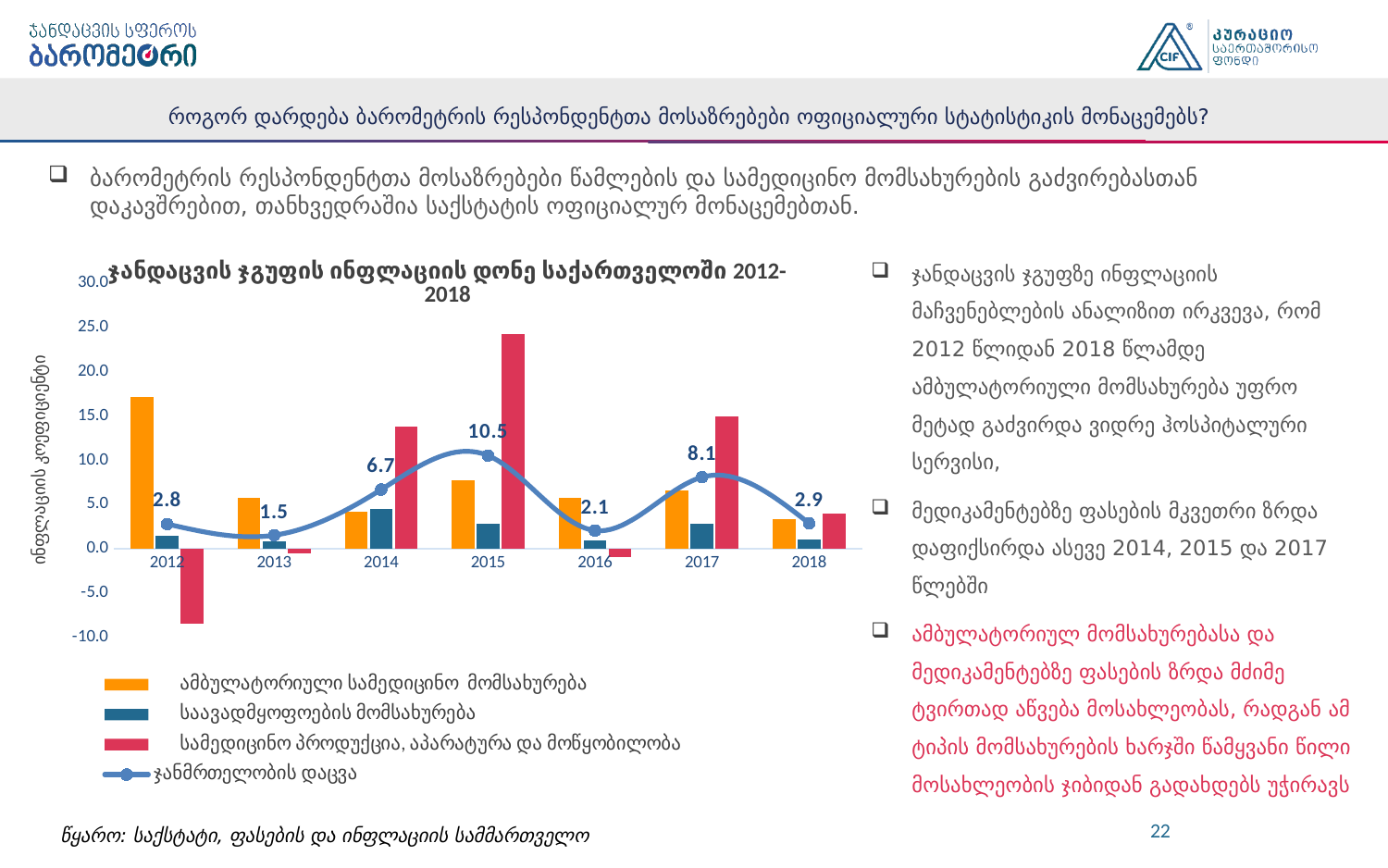
What is the difference between the ჯანმრთელობის დაცვა line values for 2015 and 2013? 9.0 What kind of chart is shown on the slide? Combined bar and line chart Is the value of the red სამედიცინო პროდუქცია, აპარატურა და მოწყობილობა bar for 2015 greater or less than 20.0? greater How many years are shown on the x axis of the chart? 7 Is the value of the orange ამბულატორიული სამედიცინო მომსახურება bar for 2012 greater or less than 15.0? greater In which year does the ჯანმრთელობის დაცვა line reach its highest value? 2015 What is the value of the ჯანმრთელობის დაცვა line for 2017? 8.1 How many series does the chart legend list? 4 In which year does the ჯანმრთელობის დაცვა line have its lowest value? 2013 What is the value of the ჯანმრთელობის დაცვა line for 2015? 10.5 Which year has the larger ჯანმრთელობის დაცვა line value, 2014 or 2017? 2017 What is the value of the ჯანმრთელობის დაცვა line for 2013? 1.5